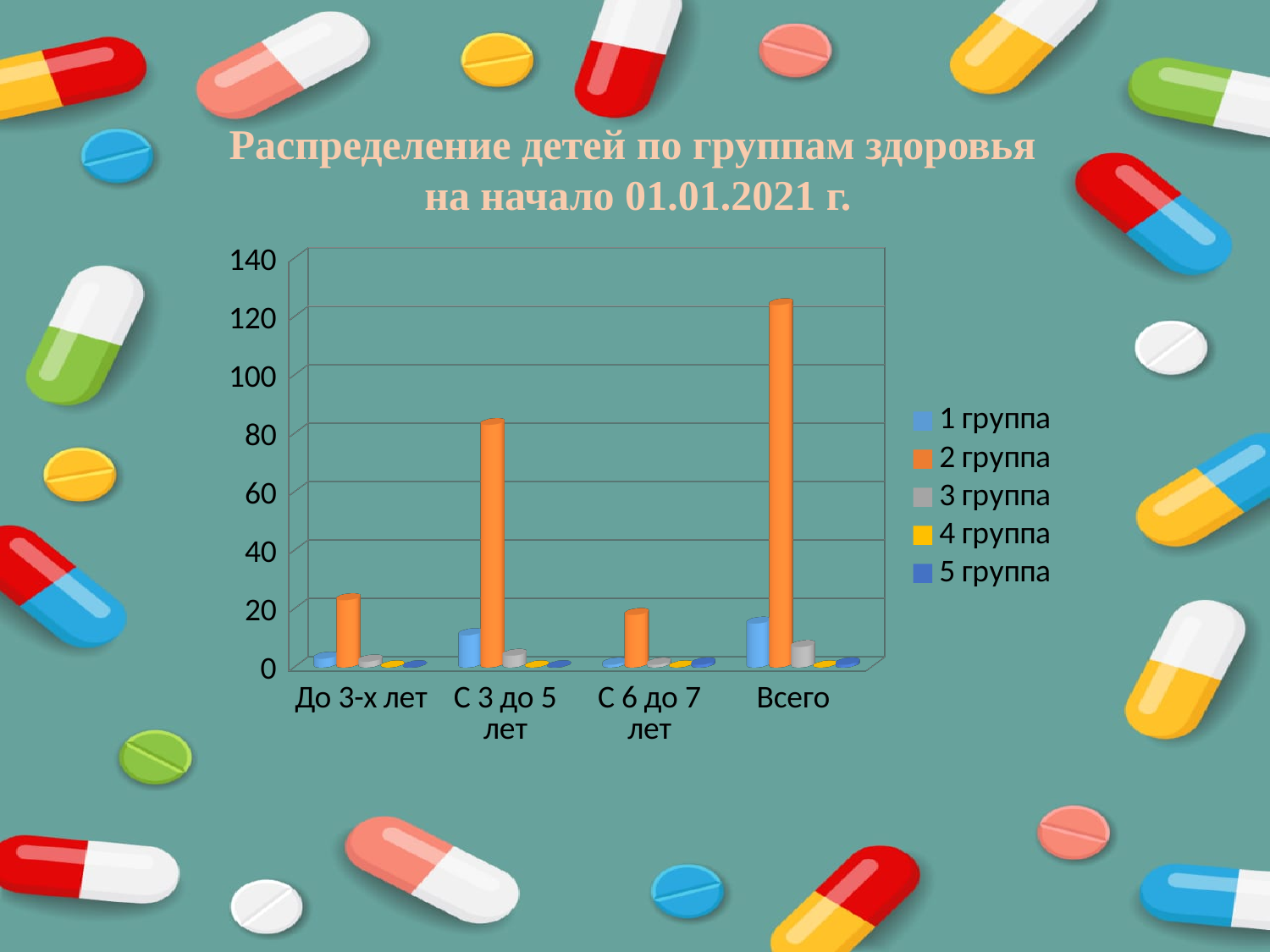
What kind of chart is shown on the slide? bar chart What is the title of the chart? Распределение детей по группам здоровья на начало 01.01.2021 г. Is the value for 2 группа in the Всего category greater or less than 100? greater How many series does the legend list? 5 Is the value for 2 группа in the С 3 до 5 лет category greater or less than 60? greater Is the value for 2 группа in the До 3-х лет category greater or less than 40? less How many categories are shown on the x axis? 4 Which series is shown in orange in the legend? 2 группа Which series has the highest value in the Всего category? 2 группа Which category has the highest value for 2 группа? Всего Which is larger for 2 группа: the value for С 3 до 5 лет or the value for До 3-х лет? С 3 до 5 лет